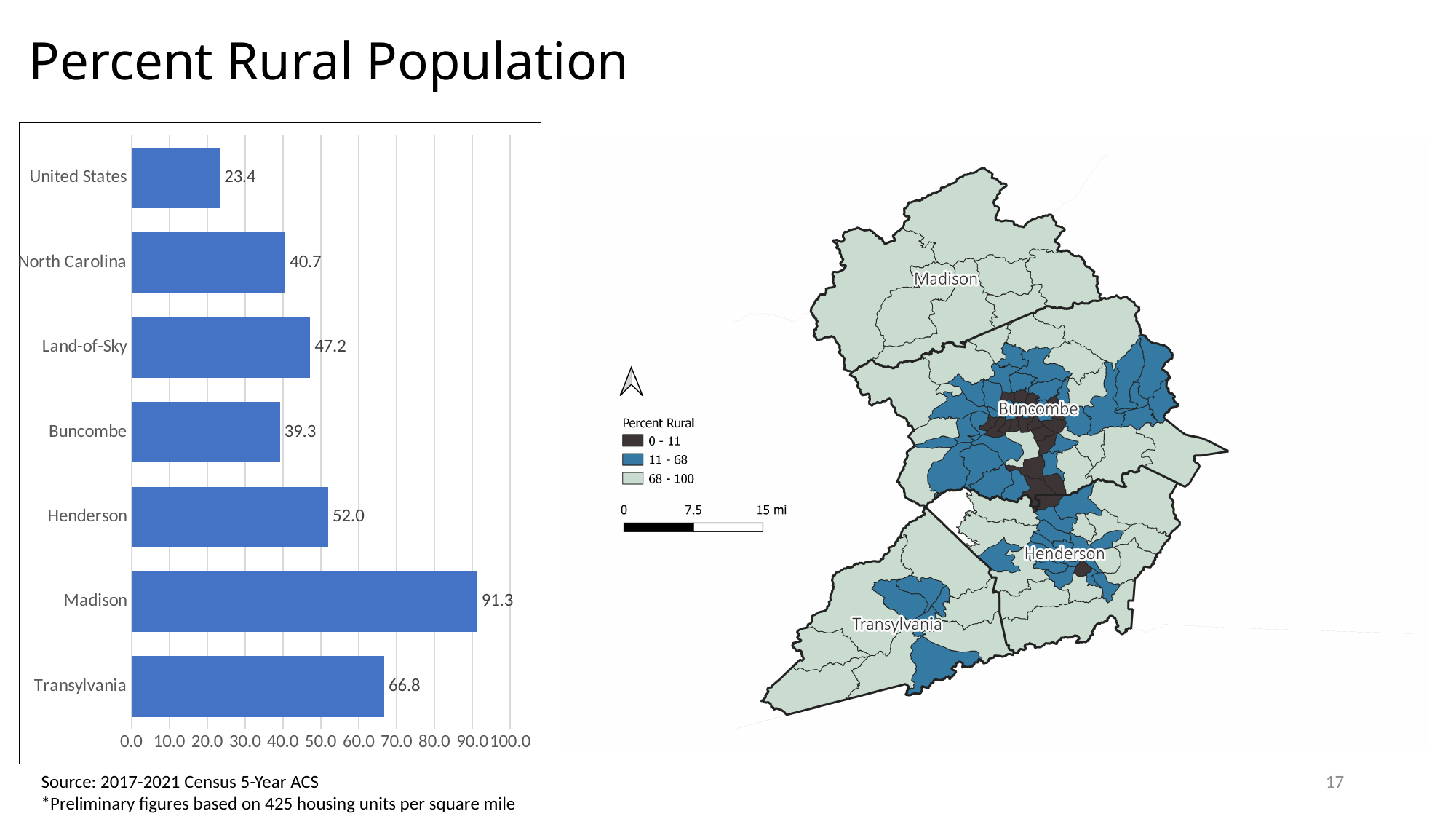
What is the title of the slide? Percent Rural Population What type of chart is shown on the left of the slide? bar chart What is the percent rural population for Henderson? 52.0 How many categories are shown in the bar chart? 7 What is the percent rural population for Madison? 91.3 What is the percent rural population for the United States? 23.4 What is the difference between the percent rural population of Madison and Transylvania? 24.5 Which category has the lowest percent rural population? United States What is the difference between the percent rural population of North Carolina and the United States? 17.3 Which has a higher percent rural population, Buncombe or Henderson? Henderson Which category has the highest percent rural population? Madison Is the value for Land-of-Sky greater or less than 50.0? less